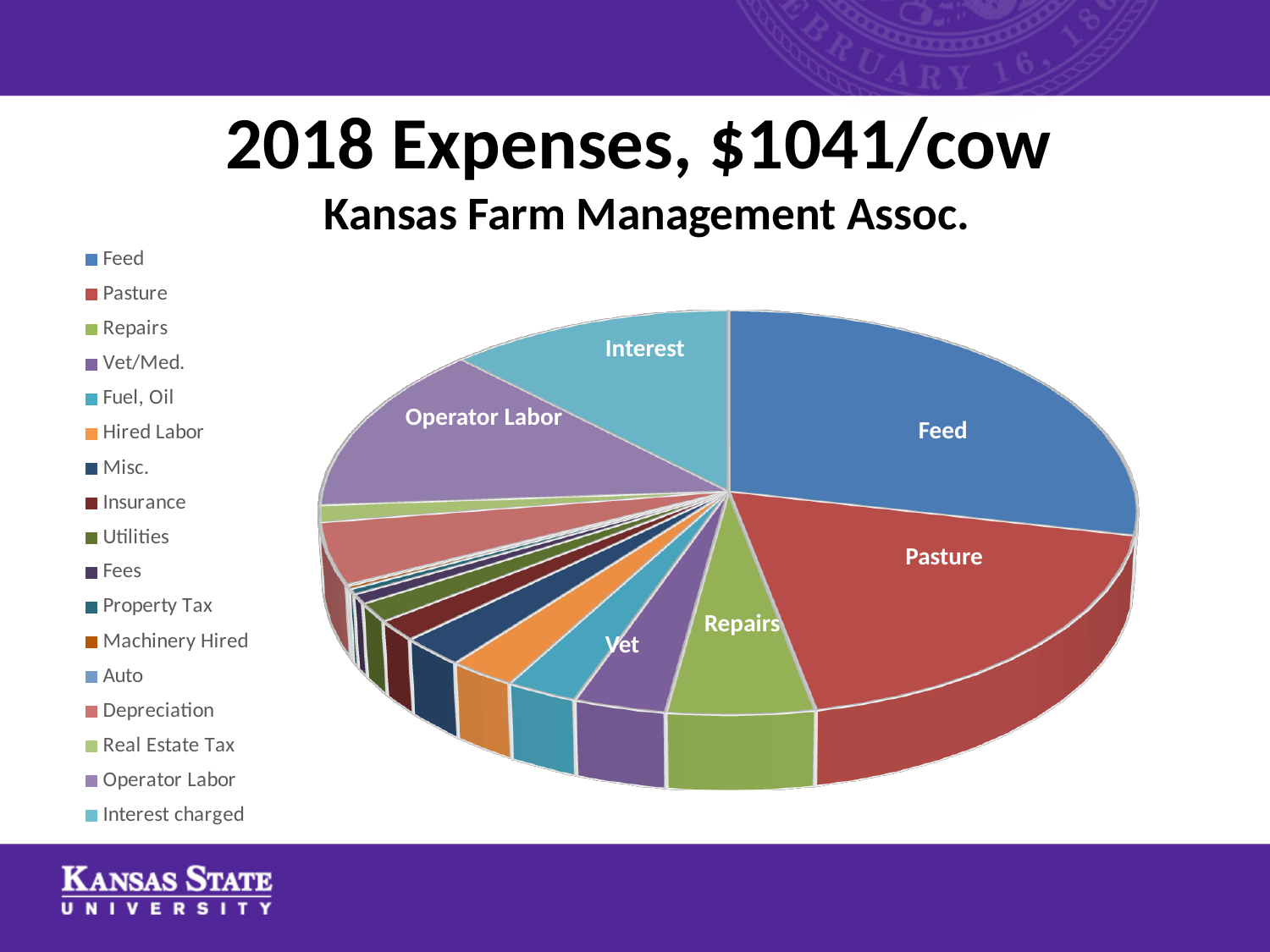
Which slice is larger, Pasture or Interest? Pasture What total expense per cow is stated in the chart title? $1041/cow Which slice is larger, Feed or Vet? Feed Which slice is larger, Operator Labor or Repairs? Operator Labor Which organization is named as the source in the subtitle? Kansas Farm Management Assoc. What kind of chart is shown on the slide? pie chart How many expense categories does the legend list? 17